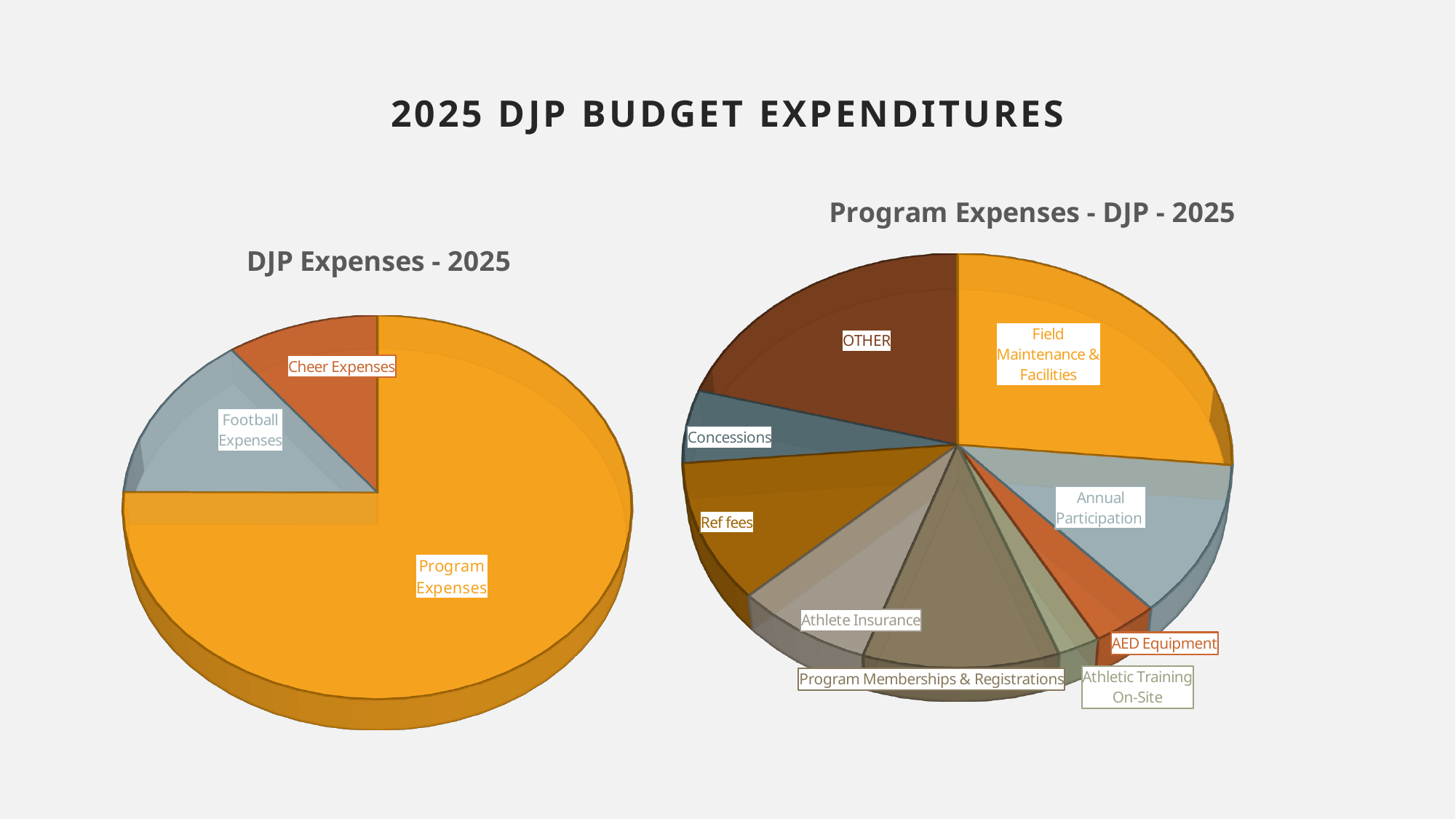
In the 'Program Expenses - DJP - 2025' chart, which category has the largest slice? Field Maintenance & Facilities In the 'Program Expenses - DJP - 2025' chart, which is larger: Concessions or Field Maintenance & Facilities? Field Maintenance & Facilities In the 'Program Expenses - DJP - 2025' chart, how many slices are there? 9 In the 'Program Expenses - DJP - 2025' chart, which is larger: OTHER or AED Equipment? OTHER In the 'DJP Expenses - 2025' chart, how many slices are there? 3 What kind of chart is the 'Program Expenses - DJP - 2025' chart? pie chart In the 'Program Expenses - DJP - 2025' chart, which is larger: Program Memberships & Registrations or Athletic Training On-Site? Program Memberships & Registrations What is the title of the chart on the left of the slide? DJP Expenses - 2025 What kind of chart is the 'DJP Expenses - 2025' chart? pie chart In the 'DJP Expenses - 2025' chart, which category has the largest slice? Program Expenses What is the title of the chart on the right of the slide? Program Expenses - DJP - 2025